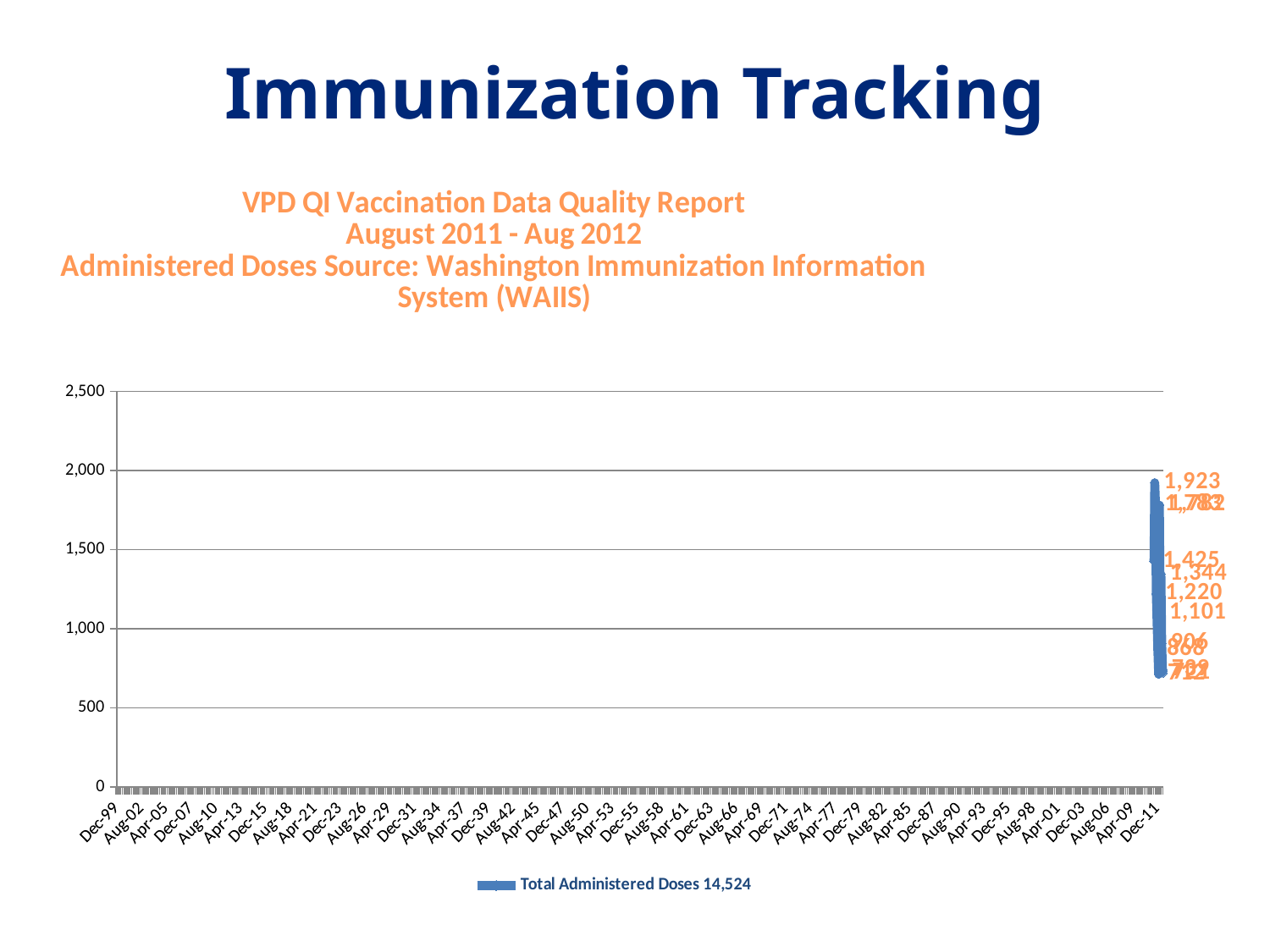
What is the legend entry for the plotted series? Total Administered Doses 14,524 What is the difference between the data labels 1,923 and 1,101? 822 What is the highest data label shown on the chart? 1,923 Is the lowest plotted value greater or less than 1,000? less What is the highest value shown on the vertical axis? 2,500 Is the highest plotted value greater or less than 2,000? less Which is larger, the data label 1,425 or the data label 1,344? 1,425 What kind of chart is shown on the slide? line chart How many series does the chart legend list? 1